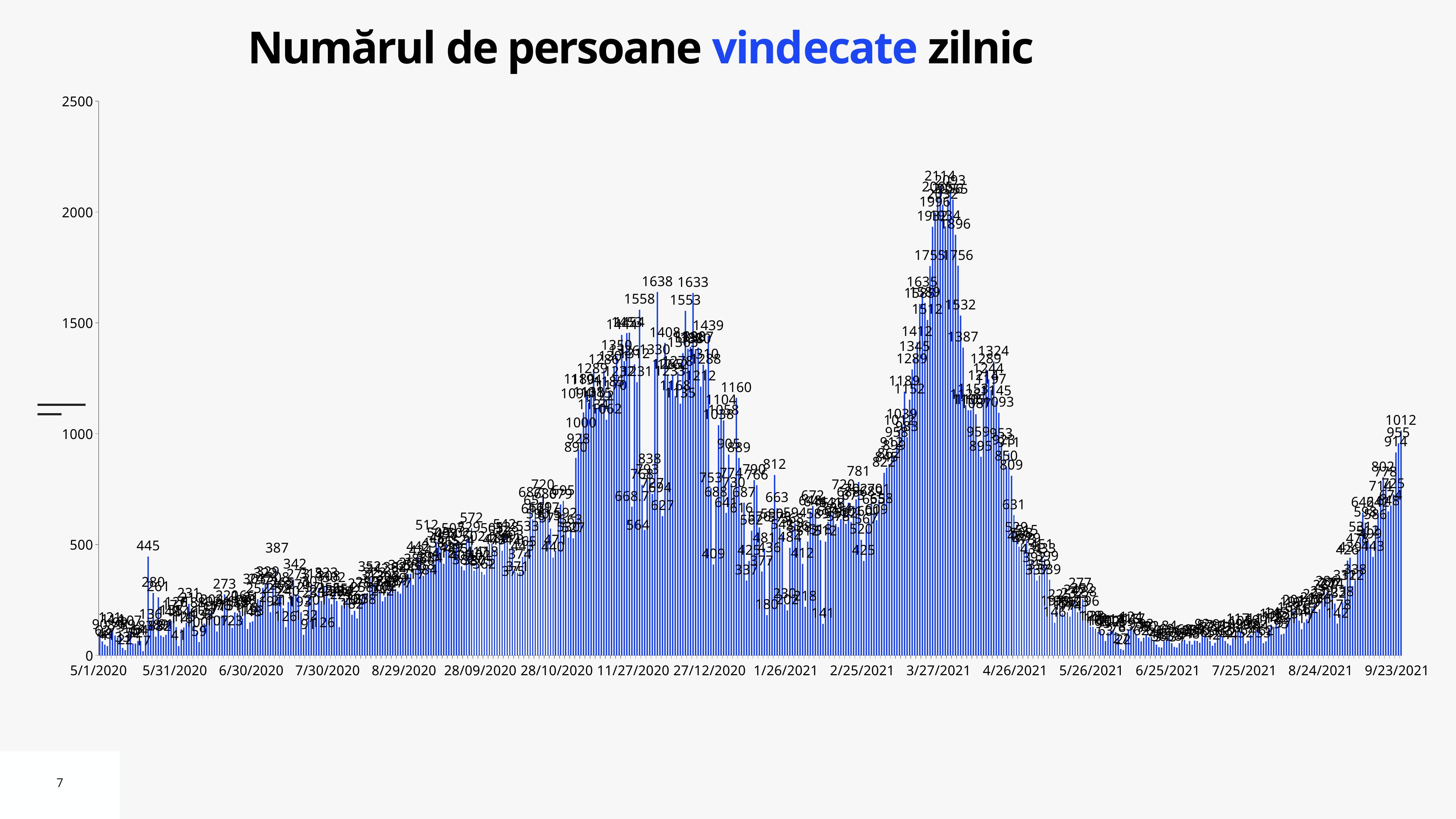
What kind of chart is shown on the slide? bar chart What is the title of the chart? Numărul de persoane vindecate zilnic Do the values rise or fall between 7/25/2021 and 9/23/2021? rise Do the values rise or fall between 4/26/2021 and 5/26/2021? fall Is the tallest bar near 3/27/2021 greater or less than 2000? greater Are the values around 6/25/2021 greater or less than 500? less What is the value labelled on the rightmost bar of the chart? 1012 What is the difference between the peak value 2114 and the peak value 1638? 476 Which peak is higher: the one near 11/27/2020 or the one near 3/27/2021? the one near 3/27/2021 What is the highest value shown on the vertical axis? 2500 What is the first date shown on the horizontal axis? 5/1/2020 What is the highest daily value labelled on the chart? 2114